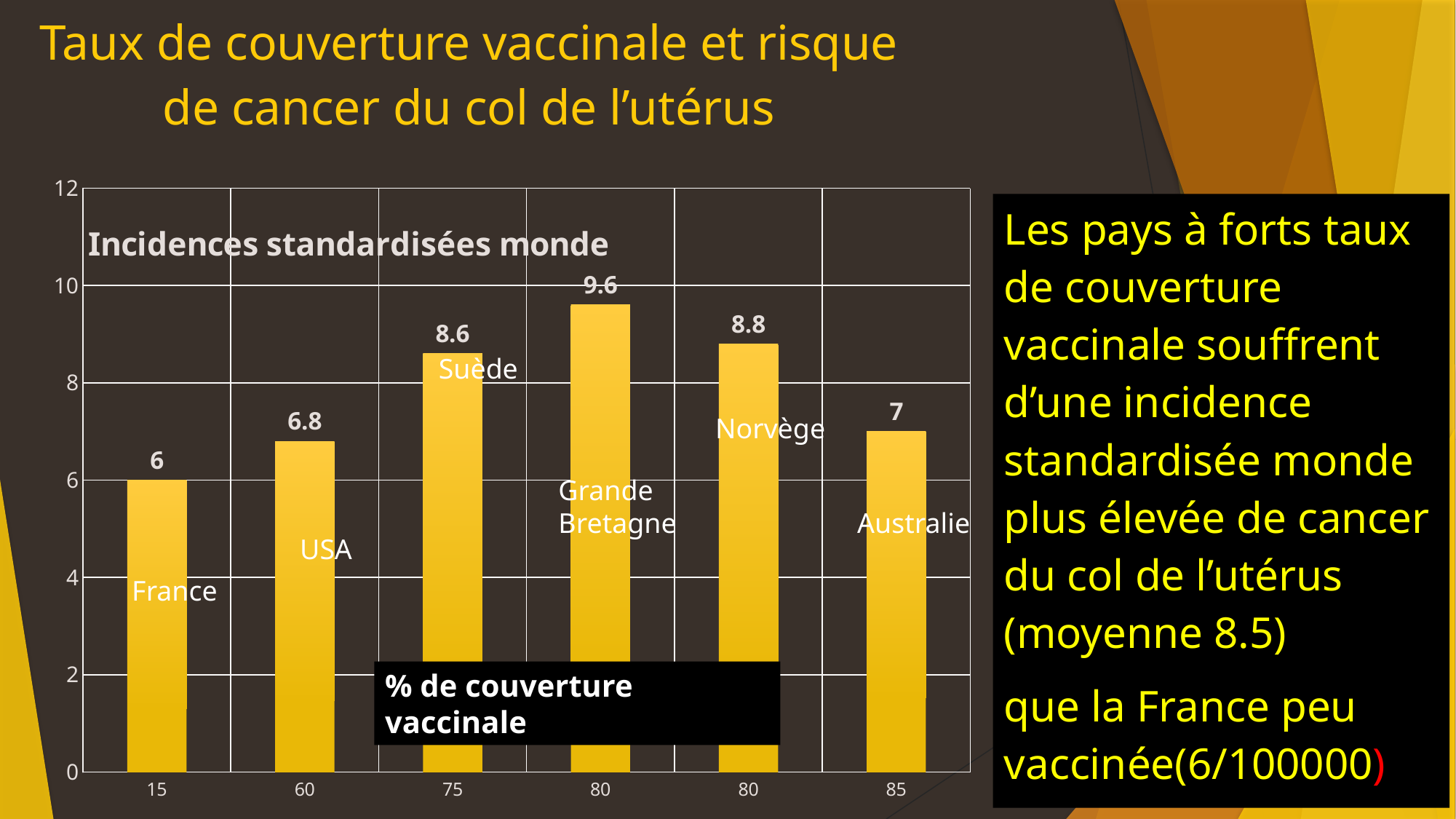
How many bars are plotted in the chart? 6 What is the value shown for the bar labelled Norvège? 8.8 What type of chart is shown on the slide? bar chart What is the value shown for the bar labelled Suède? 8.6 What is the label of the x axis of the chart? % de couverture vaccinale Which country has the lowest bar in the chart? France What is the value shown for the bar labelled Grande Bretagne? 9.6 Which has a larger value, USA or Australie? Australie What is the standardised incidence value shown for France? 6 What vaccination coverage percentage is shown on the x axis for Australie? 85 What is the difference between the values for Grande Bretagne and France? 3.6 Which country has the highest bar in the chart? Grande Bretagne